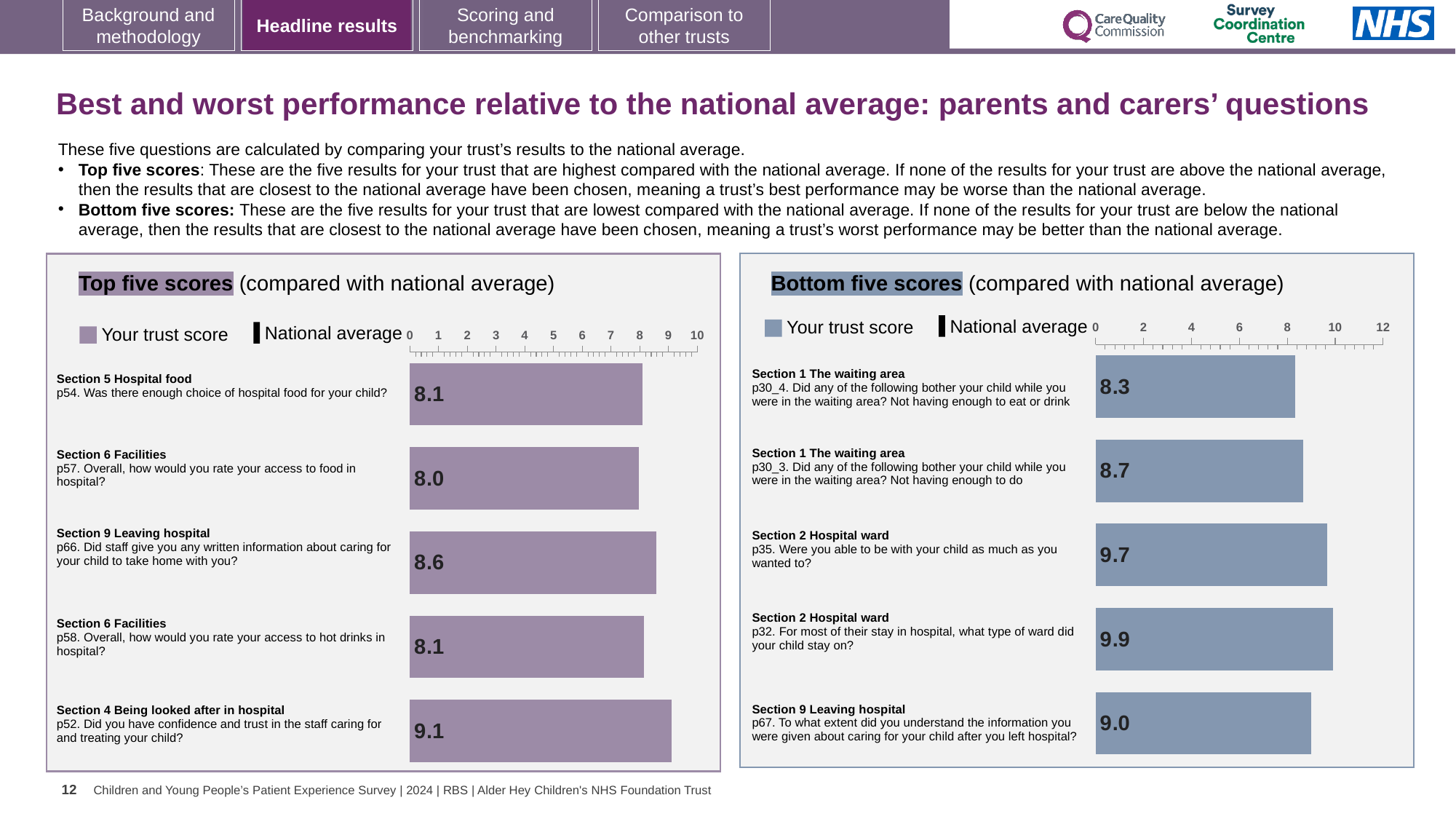
In the Bottom five scores chart, which question has the highest trust score? p32. For most of their stay in hospital, what type of ward did your child stay on? How many questions are plotted in the Top five scores chart? 5 In the Top five scores chart, which question has the highest trust score? p52. Did you have confidence and trust in the staff caring for and treating your child? In the Top five scores chart, which question has the lowest trust score? p57. Overall, how would you rate your access to food in hospital? In the Bottom five scores chart, what is the trust score for p30_3 (Not having enough to do)? 8.7 In the Top five scores chart, what is the difference between the trust scores for p52 and p57? 1.1 What kind of chart is the Bottom five scores chart? Bar chart In the Bottom five scores chart, what is the trust score for p67 (To what extent did you understand the information you were given about caring for your child after you left hospital?)? 9.0 In the Top five scores chart, what is the trust score for p66 (Did staff give you any written information about caring for your child to take home with you?)? 8.6 In the Bottom five scores chart, is the trust score for p35 larger than the trust score for p30_4? Yes, 9.7 is larger than 8.3 In the Bottom five scores chart, which question has the lowest trust score? p30_4. Did any of the following bother your child while you were in the waiting area? Not having enough to eat or drink In the Top five scores chart, what is the trust score for p54 (Was there enough choice of hospital food for your child?)? 8.1